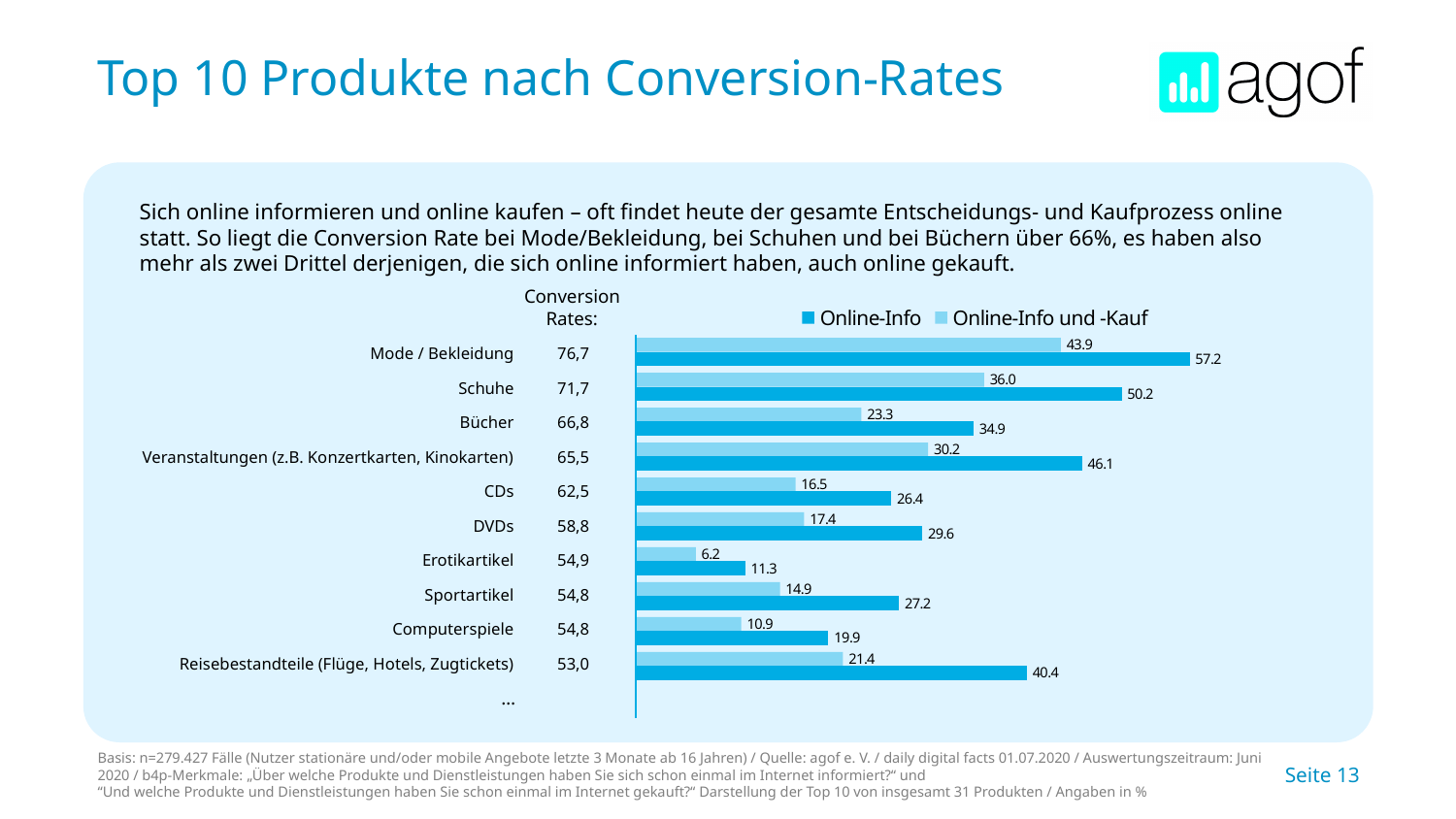
What is the Online-Info value for Computerspiele? 19.9 What is the Online-Info value for Mode / Bekleidung? 57.2 How many series does the legend list? 2 Which category has the highest Online-Info value? Mode / Bekleidung How many product categories are shown in the chart? 10 What kind of chart is shown on the slide? Bar chart What are the two series named in the legend? Online-Info and Online-Info und -Kauf What is the difference between the Online-Info and Online-Info und -Kauf values for Mode / Bekleidung? 13.3 Which category has the lowest Online-Info und -Kauf value? Erotikartikel Which has the larger Online-Info value: Veranstaltungen (z.B. Konzertkarten, Kinokarten) or Reisebestandteile (Flüge, Hotels, Zugtickets)? Veranstaltungen (z.B. Konzertkarten, Kinokarten) What is the difference between the Online-Info and Online-Info und -Kauf values for Schuhe? 14.2 What is the Online-Info und -Kauf value for Schuhe? 36.0